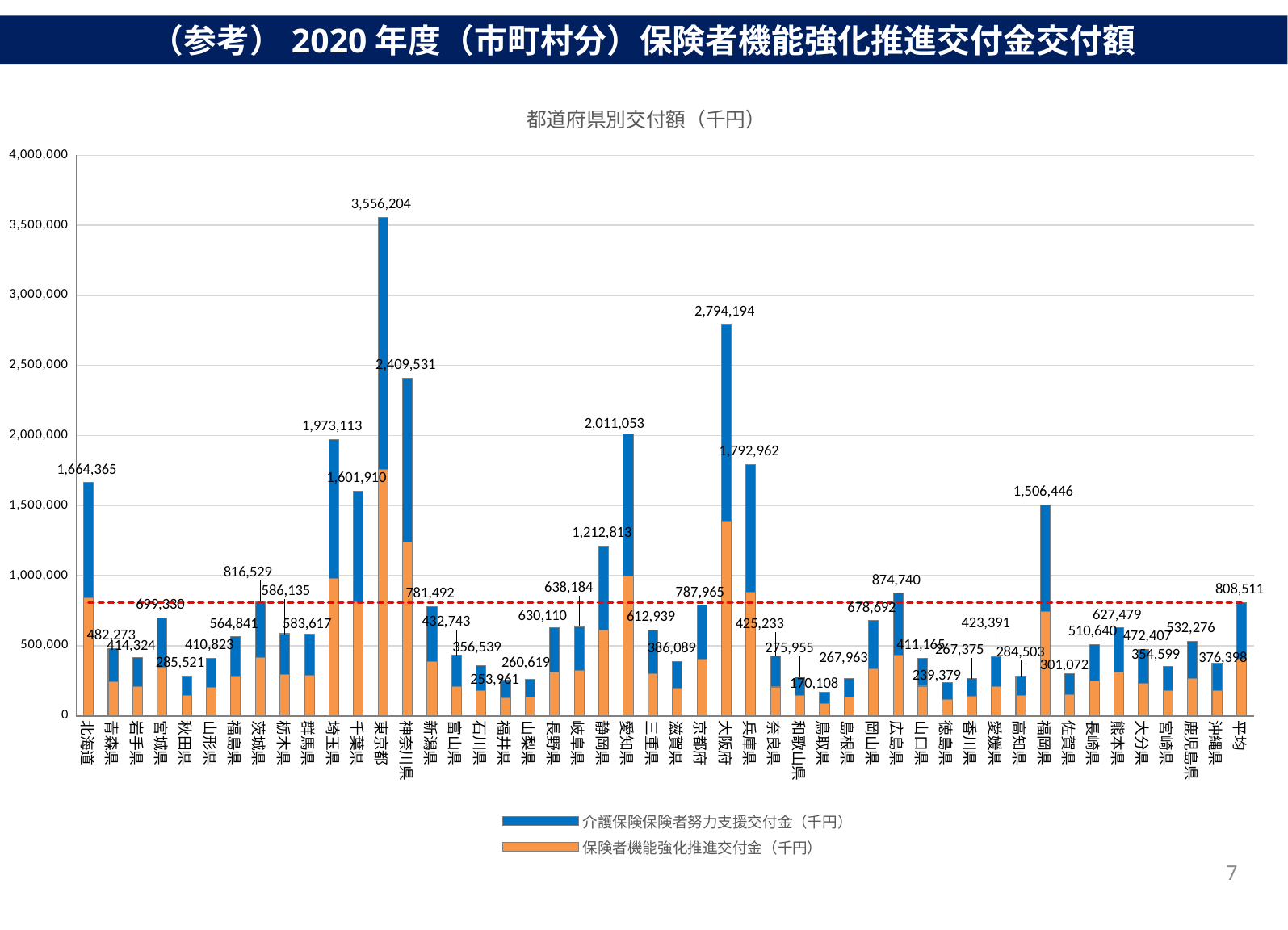
What is the total 交付額 for 東京都? 3,556,204 What is the difference between the total 交付額 of 東京都 and 大阪府? 762,010 Which has a larger total 交付額, 愛知県 or 埼玉県? 愛知県 What is the total 交付額 for 鳥取県? 170,108 What is the total 交付額 for 大阪府? 2,794,194 How many series does the legend list? 2 Is the total 交付額 for 北海道 greater or less than 1,500,000? greater Which prefecture has the highest total 交付額? 東京都 What kind of chart is shown on the slide? Stacked bar chart Which prefecture has the lowest total 交付額? 鳥取県 Which series is shown in orange in the legend? 保険者機能強化推進交付金（千円） What is the value shown for 平均 (average)? 808,511